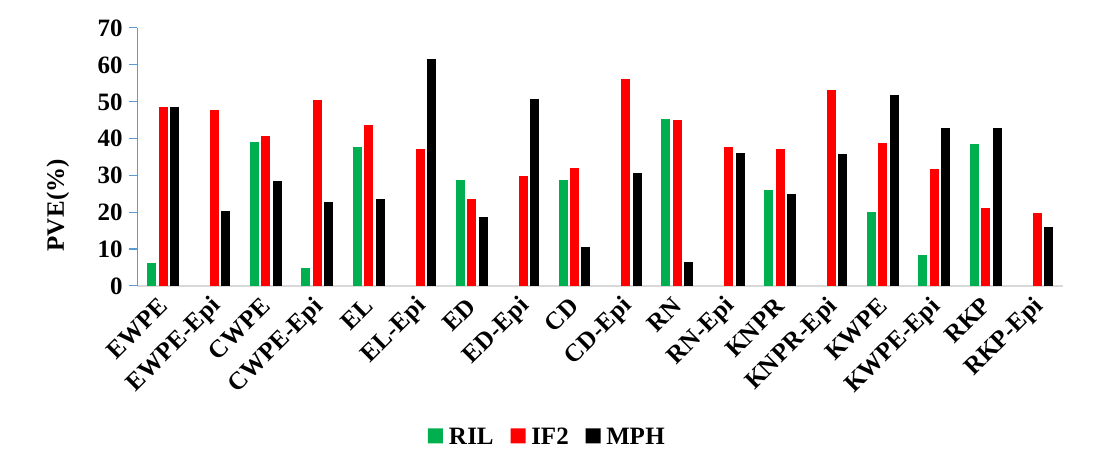
Is the RIL value for RN greater or less than 40? greater Is the IF2 value for CD-Epi greater or less than 50? greater For KWPE-Epi, which is larger: the RIL value or the MPH value? MPH Is the MPH value for RKP-Epi greater or less than 20? less What is the label of the y axis? PVE(%) How many series does the legend list? 3 How many categories are shown along the x axis? 18 Which category has the lowest MPH value? RN What kind of chart is shown on the slide? bar chart Which category has the highest MPH value? EL-Epi For ED-Epi, which is larger: the IF2 value or the MPH value? MPH